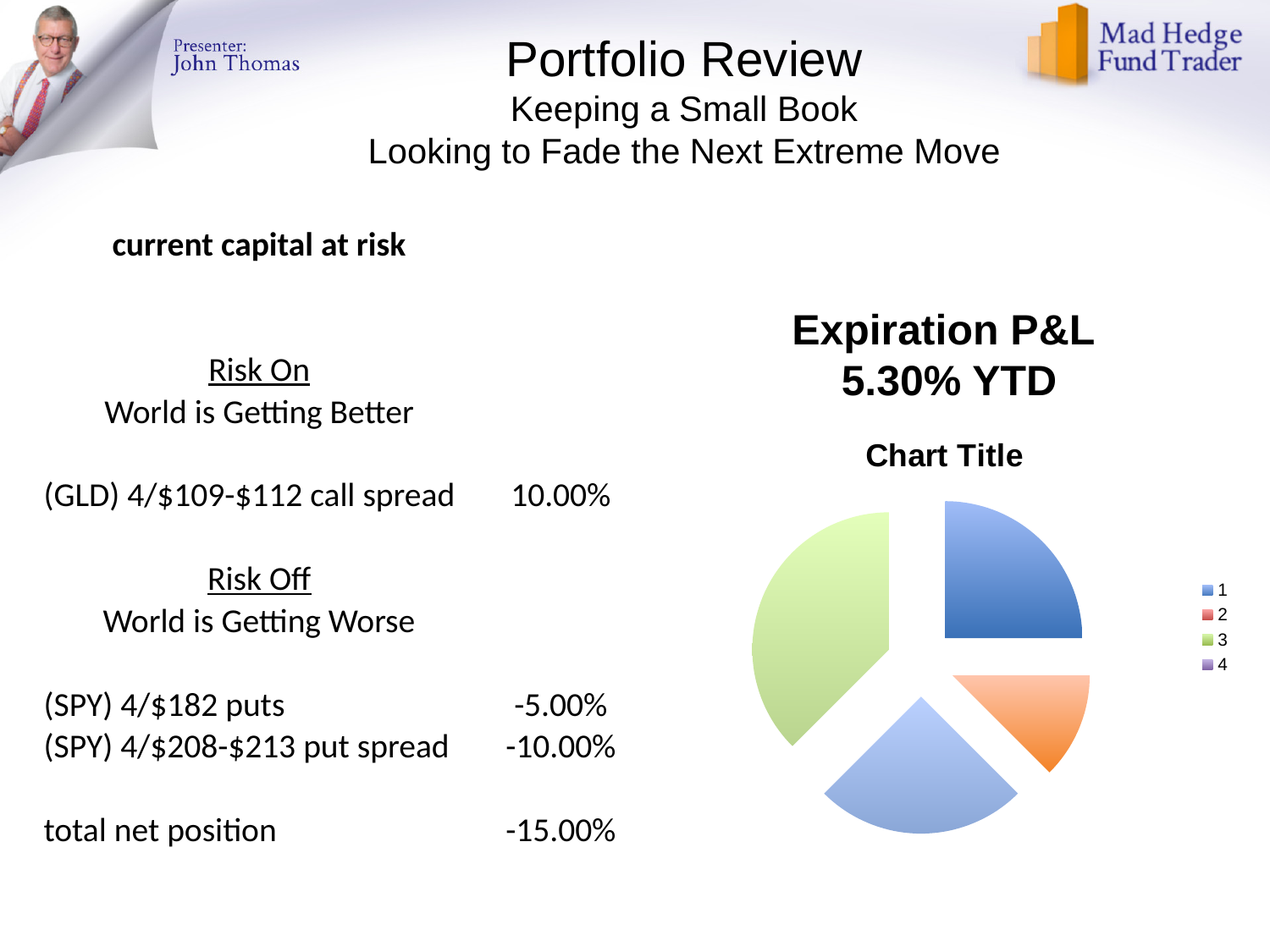
Which slice of the pie chart is the largest? the green slice In the pie chart, is the green slice larger or smaller than the orange slice? larger How many slices does the pie chart have? 4 How many entries does the legend of the pie chart list? 4 Which slice of the pie chart is the smallest? the orange slice What kind of chart is shown on the slide? pie chart What is the title shown above the pie chart? Chart Title What are the legend entries of the pie chart? 1, 2, 3, 4